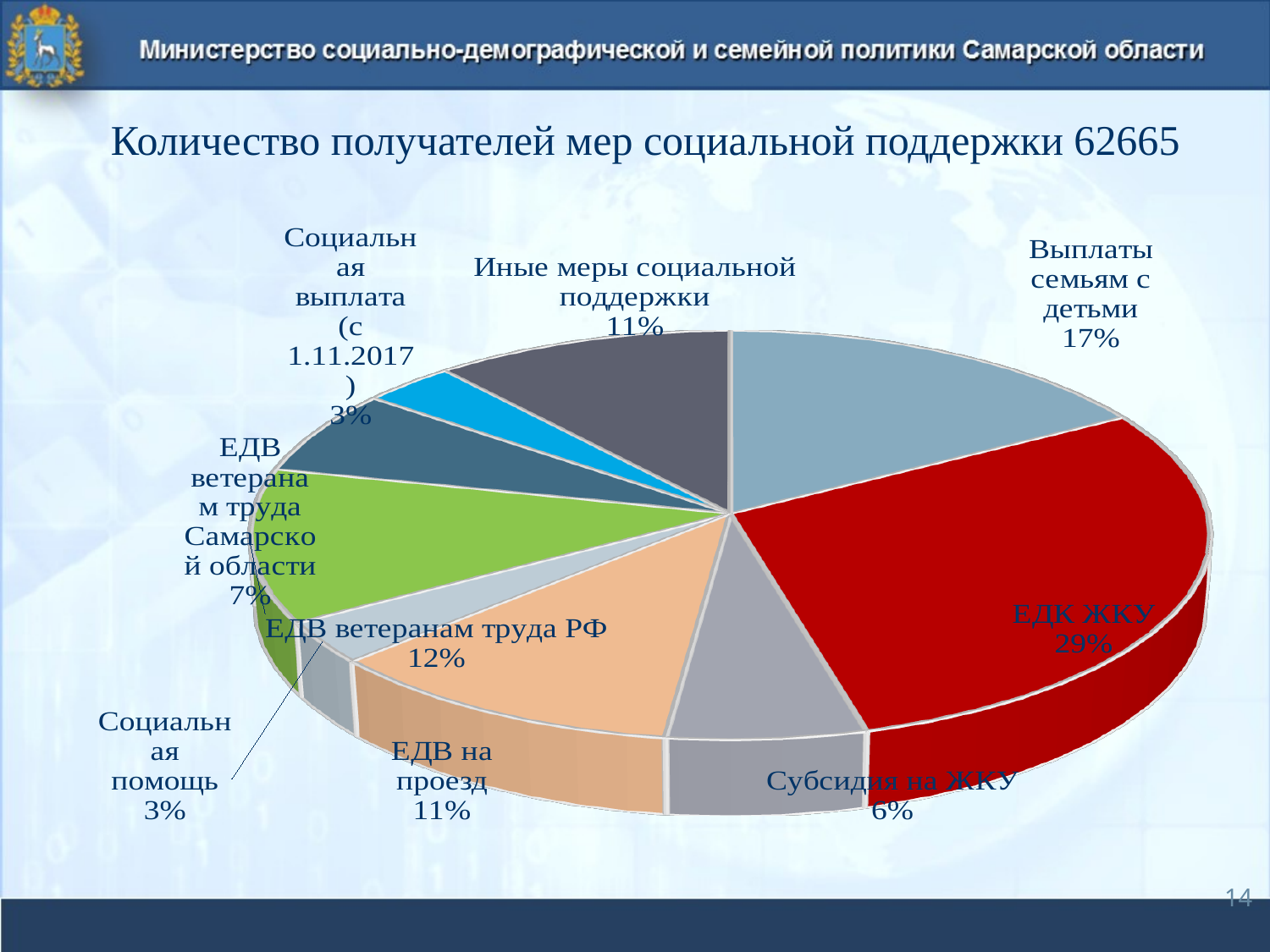
Which category has the largest share of the pie? ЕДК ЖКУ What percentage is shown for ЕДВ ветеранам труда РФ? 12% Which is larger, the share for ЕДВ на проезд or the share for Субсидия на ЖКУ? ЕДВ на проезд What kind of chart is shown on the slide? Pie chart What percentage is shown for Субсидия на ЖКУ? 6% How many slices does the pie chart have? 9 What total number of recipients is stated in the chart title? 62665 What is the difference in percentage points between ЕДК ЖКУ and Выплаты семьям с детьми? 12 What colour is the ЕДК ЖКУ slice? Red What percentage is shown for ЕДВ ветеранам труда Самарской области? 7% What share of the pie does ЕДК ЖКУ represent? 29% What percentage is shown for Выплаты семьям с детьми? 17%